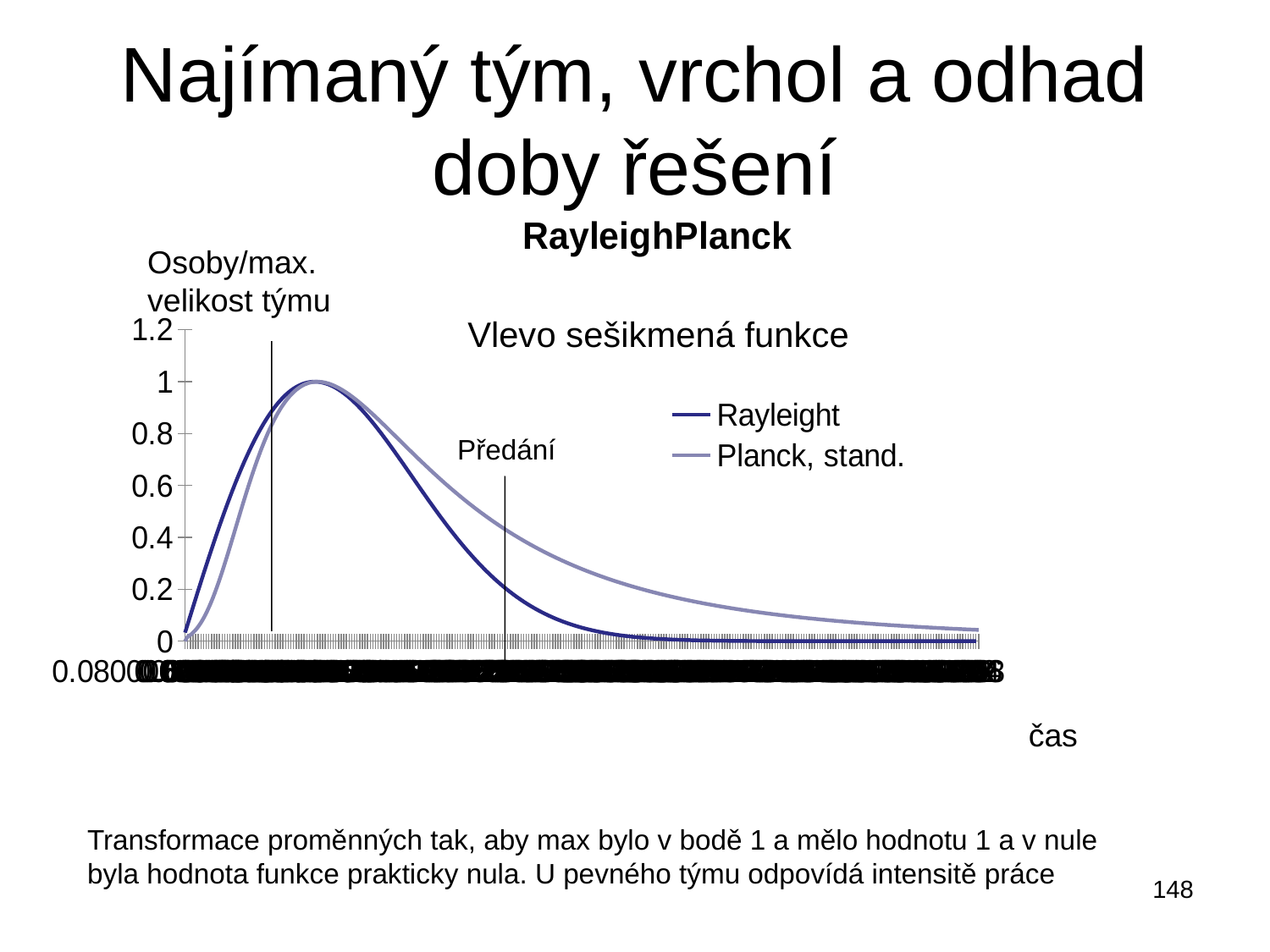
What is the highest tick value shown on the y axis? 1.2 At the vertical line labelled Předání, which series has the higher value, Rayleight or Planck, stand.? Planck, stand. At the right end of the x axis, which series has the higher value, Rayleight or Planck, stand.? Planck, stand. What is the title of the chart? RayleighPlanck What is the peak value reached by the Planck, stand. curve? 1 After reaching their peak, do the two curves rise or fall as the x axis increases? fall Is the value of the Planck, stand. curve at the Předání line greater or less than 0.2? greater Is the value of the Rayleight curve at the Předání line greater or less than 0.4? less How many series does the chart legend list? 2 What is the peak value reached by the Rayleight curve? 1 What kind of chart is shown on the slide? line chart What are the two series named in the chart legend? Rayleight and Planck, stand.